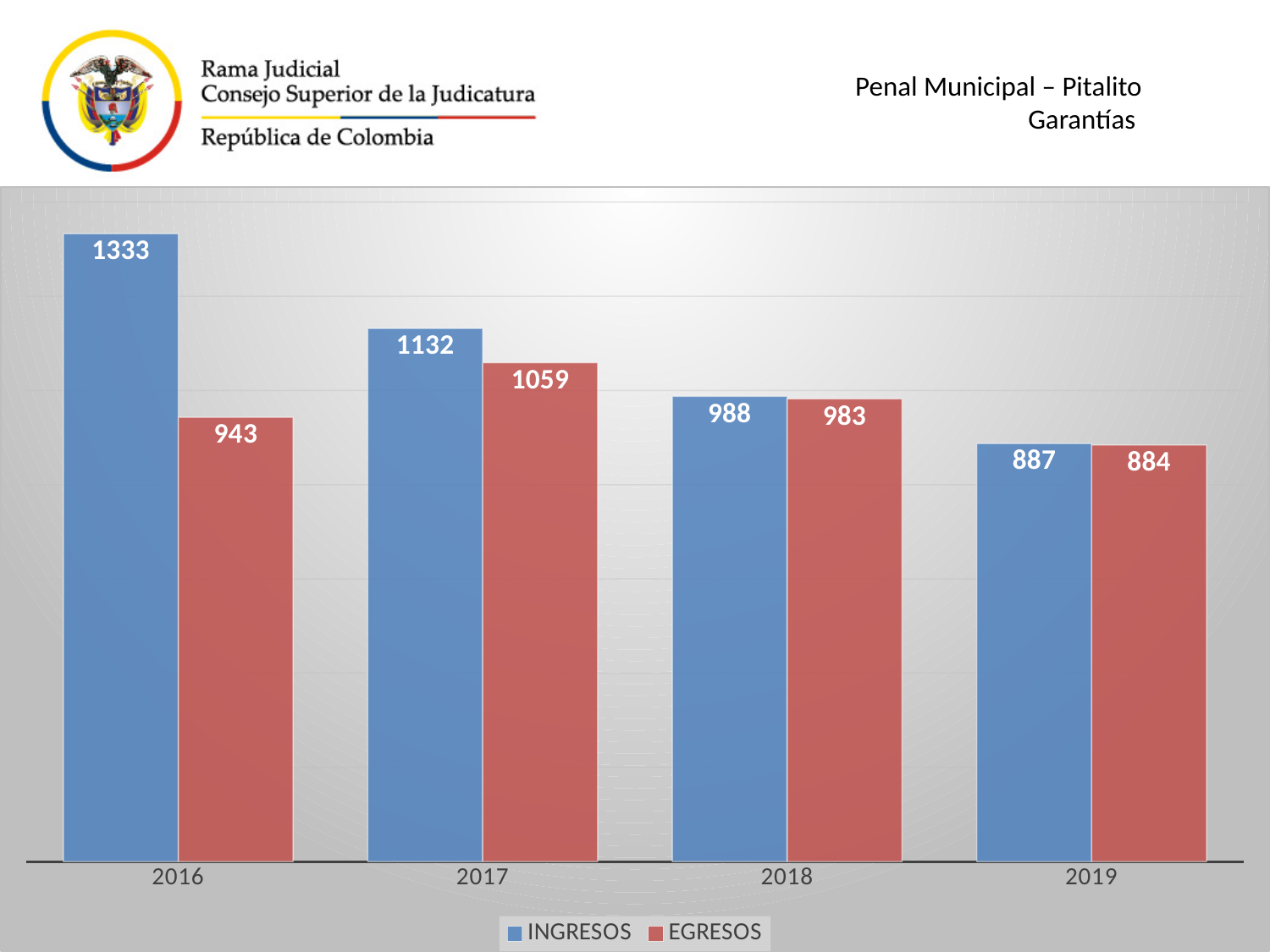
What is the INGRESOS value for 2016? 1333 What is the EGRESOS value for 2017? 1059 Which year has the highest INGRESOS value? 2016 Which year has the lowest EGRESOS value? 2019 What is the EGRESOS value for 2019? 884 How many series does the legend list? 2 What is the difference between INGRESOS and EGRESOS in 2016? 390 Do the INGRESOS values rise or fall from 2016 to 2019? Fall Which is larger in 2017, INGRESOS or EGRESOS? INGRESOS What kind of chart is shown on the slide? Bar chart What is the difference between INGRESOS in 2017 and INGRESOS in 2018? 144 How many years are shown on the x axis? 4